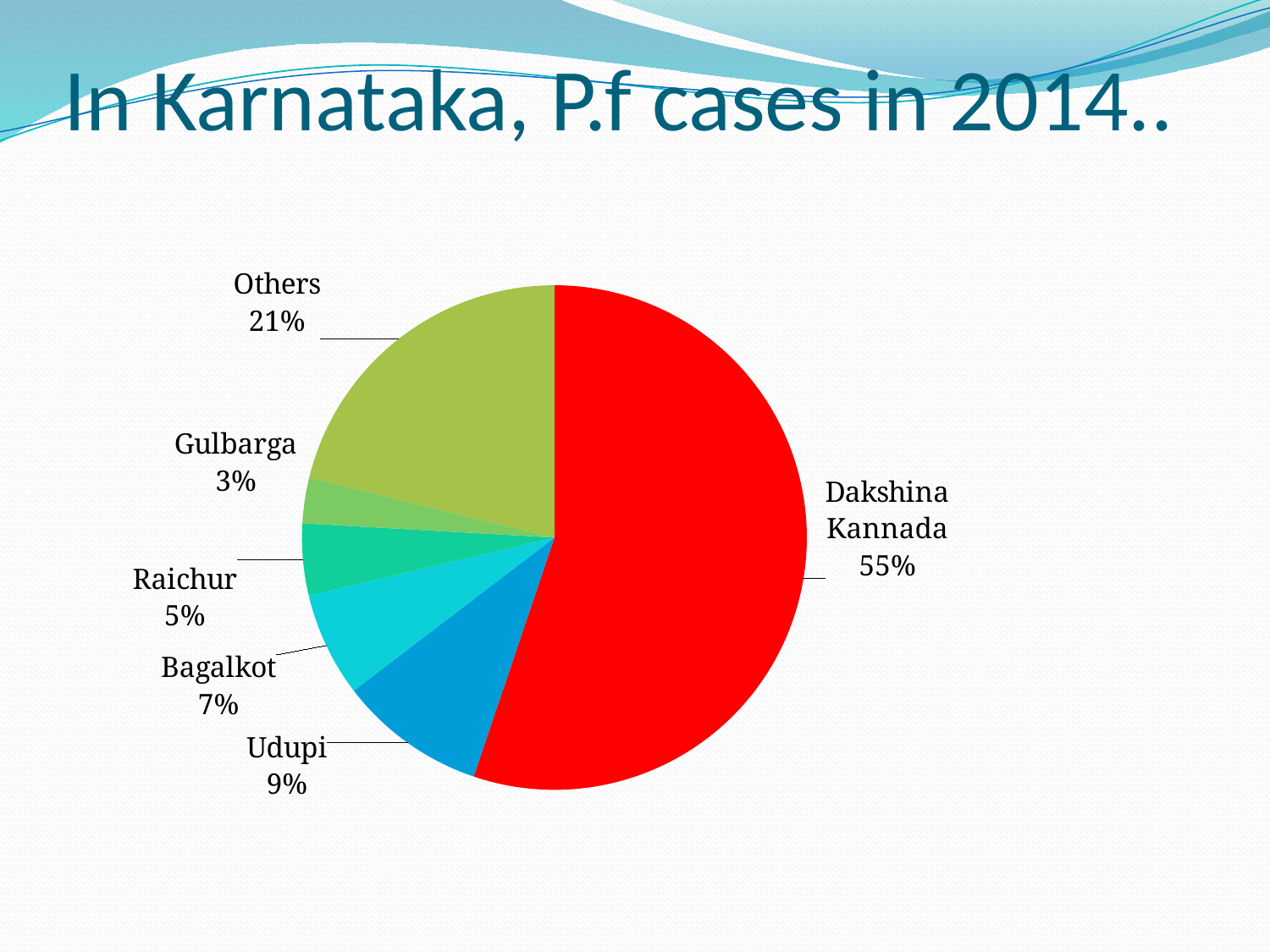
Which slice of the pie is the largest? Dakshina Kannada What share of the pie is labelled Others? 21% Which slice of the pie is the smallest? Gulbarga Which is larger, the share for Udupi or the share for Bagalkot? Udupi What percentage is shown for Bagalkot? 7% What percentage is shown for Raichur? 5% What percentage is shown for Gulbarga? 3% What is the difference in percentage points between Dakshina Kannada and Others? 34 What percentage is shown for Udupi? 9% What share of P.f cases does Dakshina Kannada account for? 55% What kind of chart is shown on the slide? pie chart How many slices does the pie chart have? 6